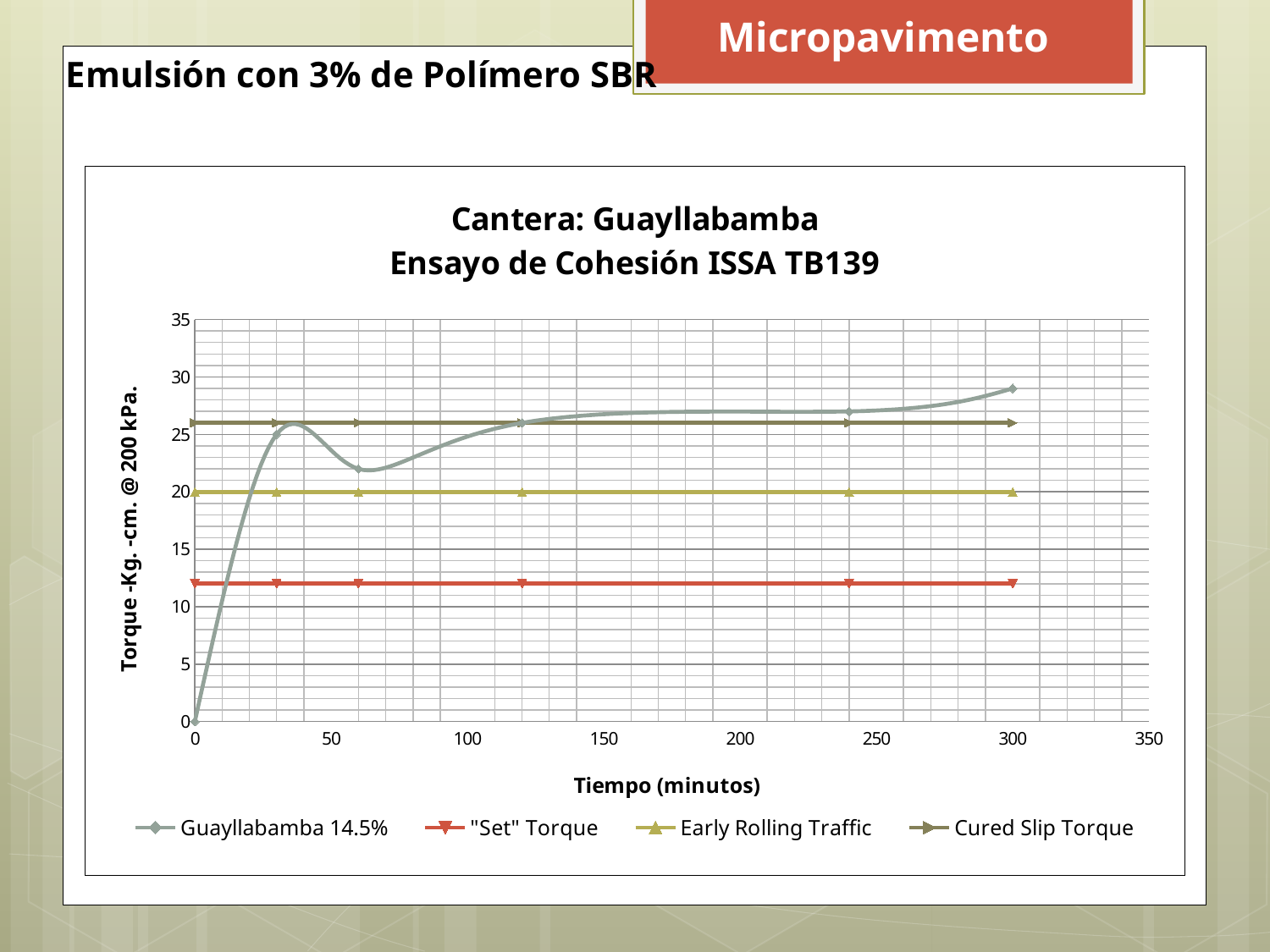
Which series has the lowest values across the chart? "Set" Torque What is the value of the Guayllabamba 14.5% series at time 0? 0 At 300 minutes, which is higher: the Guayllabamba 14.5% series or the Cured Slip Torque line? Guayllabamba 14.5% Is the value of the Guayllabamba 14.5% series at 60 minutes greater or less than 25? less Does the Guayllabamba 14.5% series overall rise or fall from 0 to 300 minutes? rise Is the value of the Cured Slip Torque line greater or less than 25? greater Is the value of the "Set" Torque line greater or less than 15? less How many series does the legend list? 4 What is the title of the chart? Cantera: Guayllabamba Ensayo de Cohesión ISSA TB139 What kind of chart is shown on the slide? line chart What is the value of the Early Rolling Traffic line? 20 What is the label of the x axis? Tiempo (minutos)